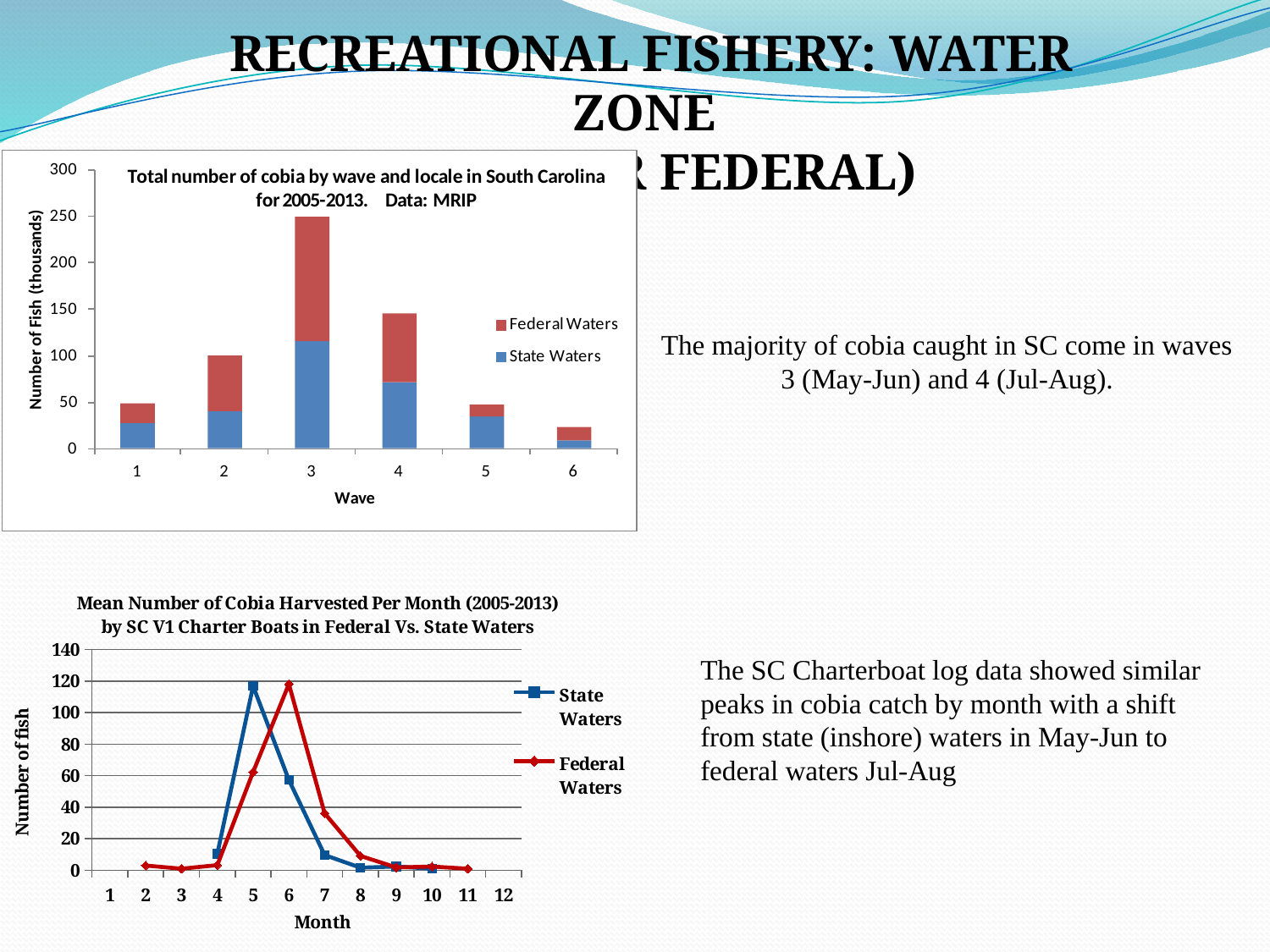
What kind of chart is the bottom chart (Mean Number of Cobia Harvested Per Month)? Line chart What kind of chart is the top chart (Total number of cobia by wave and locale)? Stacked bar chart On the top chart (Total number of cobia by wave and locale), which wave has the lowest total number of fish? Wave 6 On the bottom chart (Mean Number of Cobia Harvested Per Month), in which month does the Federal Waters series reach its highest value? Month 6 On the bottom chart (Mean Number of Cobia Harvested Per Month), in which month does the State Waters series reach its highest value? Month 5 On the top chart (Total number of cobia by wave and locale), is the total for wave 4 greater or less than 100? greater On the top chart (Total number of cobia by wave and locale), which wave has the highest total number of fish? Wave 3 On the top chart (Total number of cobia by wave and locale), is the total for wave 6 greater or less than 50? less On the bottom chart (Mean Number of Cobia Harvested Per Month), is the State Waters value for month 5 greater or less than 100? greater On the top chart (Total number of cobia by wave and locale), how many series does the legend list? 2 On the top chart (Total number of cobia by wave and locale), how many waves are shown on the x axis? 6